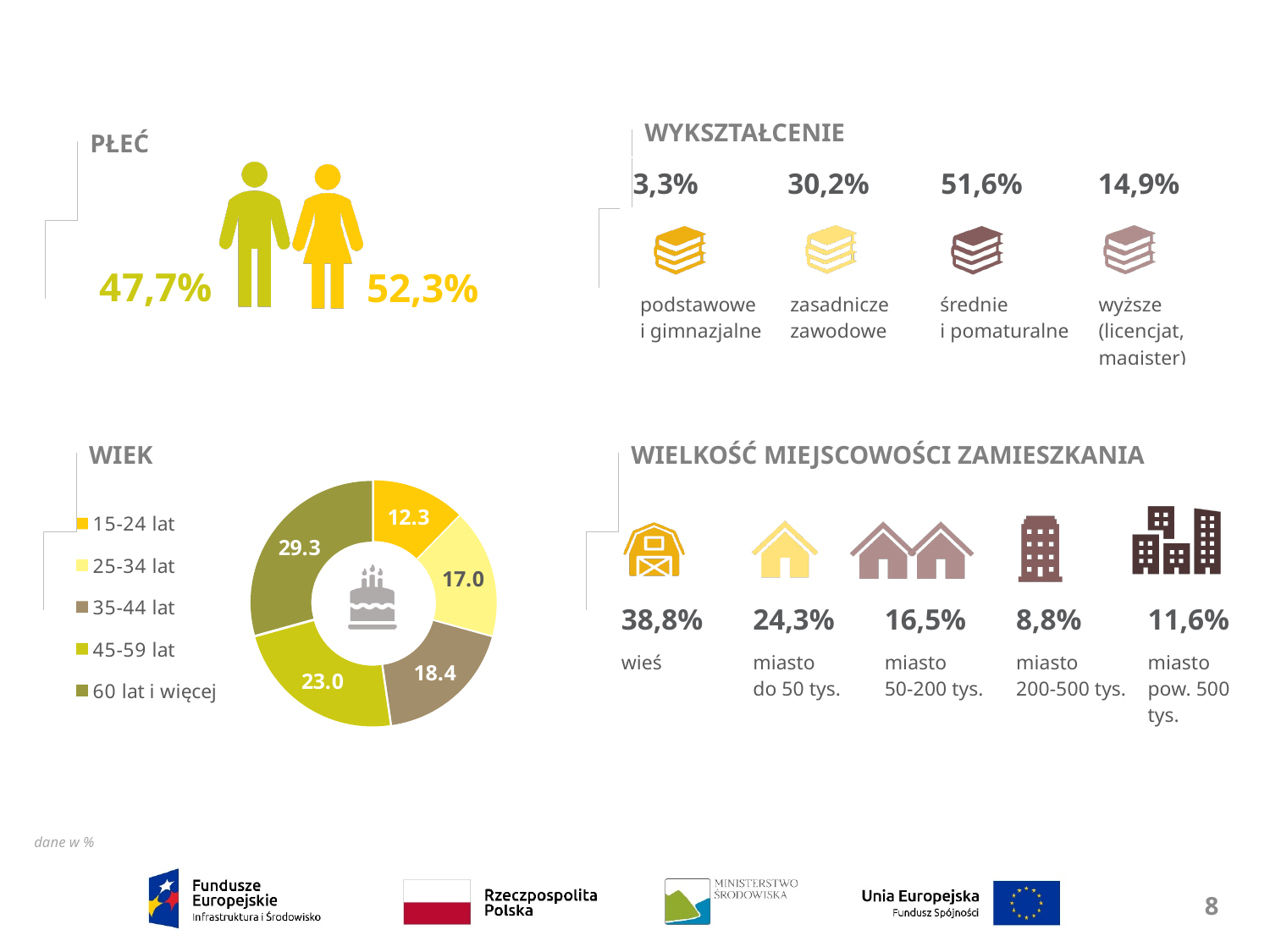
In the WIEK chart, what is the value for 35-44 lat? 18.4 What is the title of the chart in the lower left of the slide? WIEK In the WIEK chart, which is larger: the value for 45-59 lat or the value for 35-44 lat? 45-59 lat In the WIEK chart, which age group has the smallest value? 15-24 lat What kind of chart is the WIEK chart? Donut (pie) chart In the WIEK chart, what is the value for 45-59 lat? 23.0 In the WIEK chart, what is the value for 15-24 lat? 12.3 In the WIEK chart, what is the value for 60 lat i więcej? 29.3 In the WIEK chart, what is the difference between the values for 60 lat i więcej and 15-24 lat? 17.0 In the WIEK chart, which age group has the largest value? 60 lat i więcej How many age groups does the WIEK chart show? 5 In the WIEK chart, what is the value for 25-34 lat? 17.0